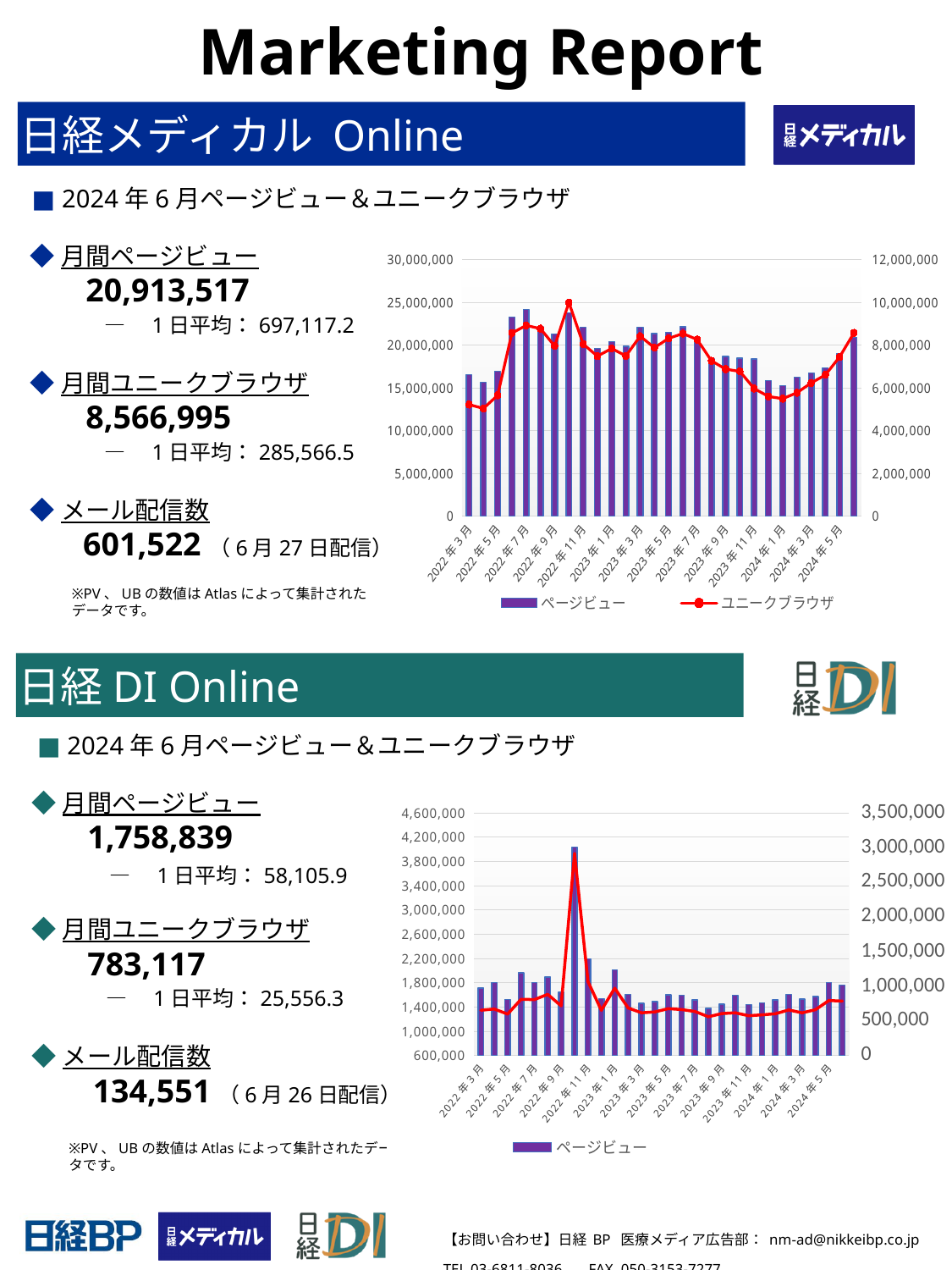
In the top chart (日経メディカル Online), is the ユニークブラウザ value for 2022年10月 greater or less than 8,000,000? greater In the bottom chart (日経DI Online), is the ページビュー bar for 2022年10月 greater or less than 3,800,000? greater In the top chart (日経メディカル Online), is the ページビュー bar for 2022年3月 greater or less than 20,000,000? less In the top chart (日経メディカル Online), what are the two legend entries? ページビュー and ユニークブラウザ In the top chart (日経メディカル Online), how many series does the legend list? 2 What kind of chart is the top chart (日経メディカル Online)? Combination bar and line chart In the bottom chart (日経DI Online), how many series does the legend list? 1 In the top chart (日経メディカル Online), do the ページビュー bars generally rise or fall from 2023年5月 to 2024年1月? fall In the bottom chart (日経DI Online), in which month is the ページビュー bar highest? 2022年10月 In the top chart (日経メディカル Online), in which month does the ユニークブラウザ line reach its highest point? 2022年10月